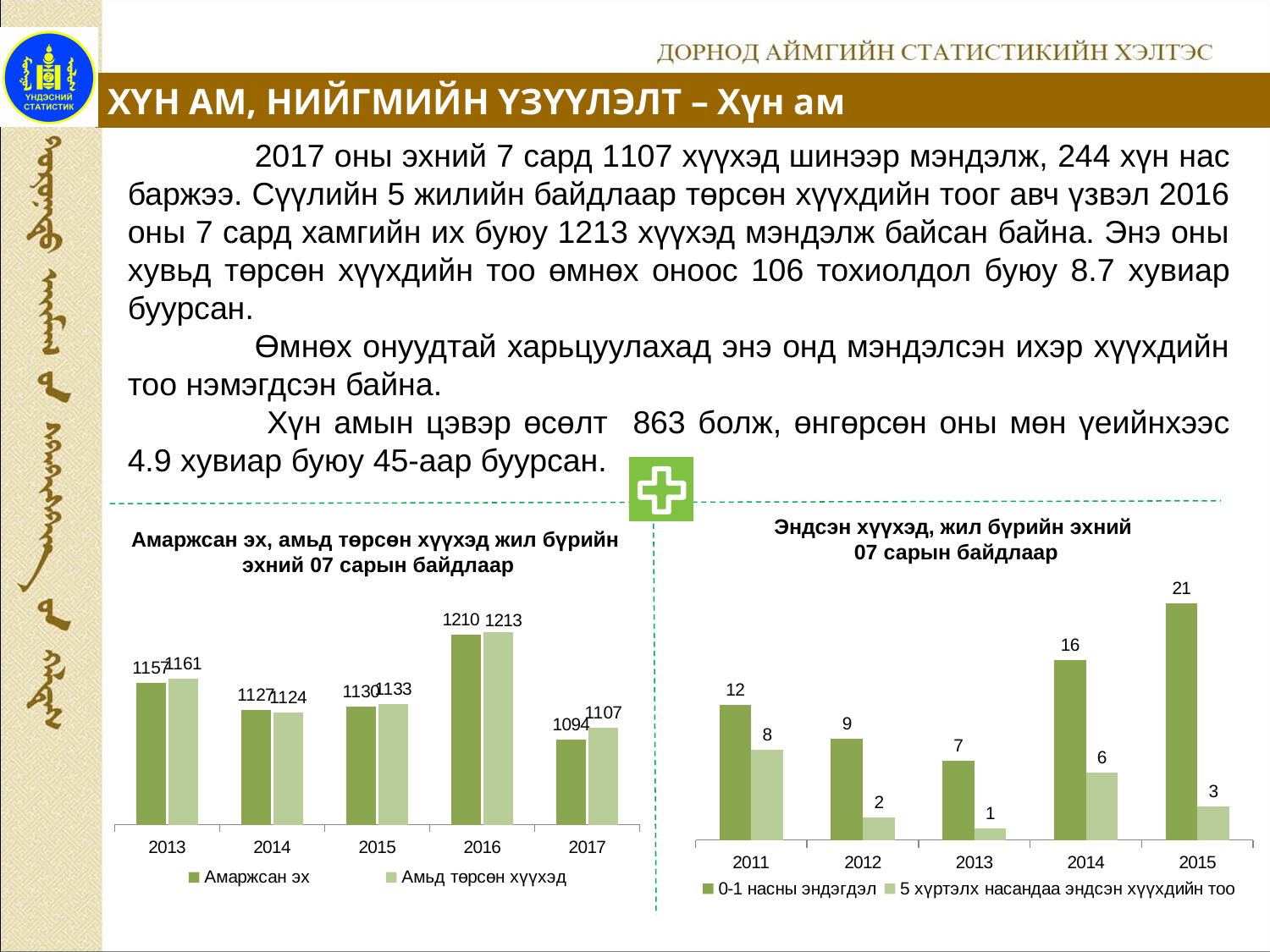
In the left chart (Амаржсан эх, амьд төрсөн хүүхэд), how many years are shown on the x axis? 5 In the right chart (Эндсэн хүүхэд), which year has the lowest value for 5 хүртэлх насандаа эндсэн хүүхдийн тоо? 2013 In the right chart (Эндсэн хүүхэд), which year has the highest value for 0-1 насны эндэгдэл? 2015 In the right chart (Эндсэн хүүхэд), which is larger in 2011: 0-1 насны эндэгдэл or 5 хүртэлх насандаа эндсэн хүүхдийн тоо? 0-1 насны эндэгдэл In the left chart (Амаржсан эх, амьд төрсөн хүүхэд), which year has the lowest value for Амаржсан эх? 2017 In the right chart (Эндсэн хүүхэд), what is the value of 5 хүртэлх насандаа эндсэн хүүхдийн тоо for 2012? 2 In the left chart (Амаржсан эх, амьд төрсөн хүүхэд), which year has the highest value for Амьд төрсөн хүүхэд? 2016 What type of chart is the right chart (Эндсэн хүүхэд)? Bar chart In the right chart (Эндсэн хүүхэд), what is the value of 0-1 насны эндэгдэл for 2014? 16 In the left chart (Амаржсан эх, амьд төрсөн хүүхэд), what is the difference between Амьд төрсөн хүүхэд in 2016 and in 2017? 106 In the left chart (Амаржсан эх, амьд төрсөн хүүхэд), what is the value of Амьд төрсөн хүүхэд for 2017? 1107 In the left chart (Амаржсан эх, амьд төрсөн хүүхэд), what is the value of Амаржсан эх for 2016? 1210